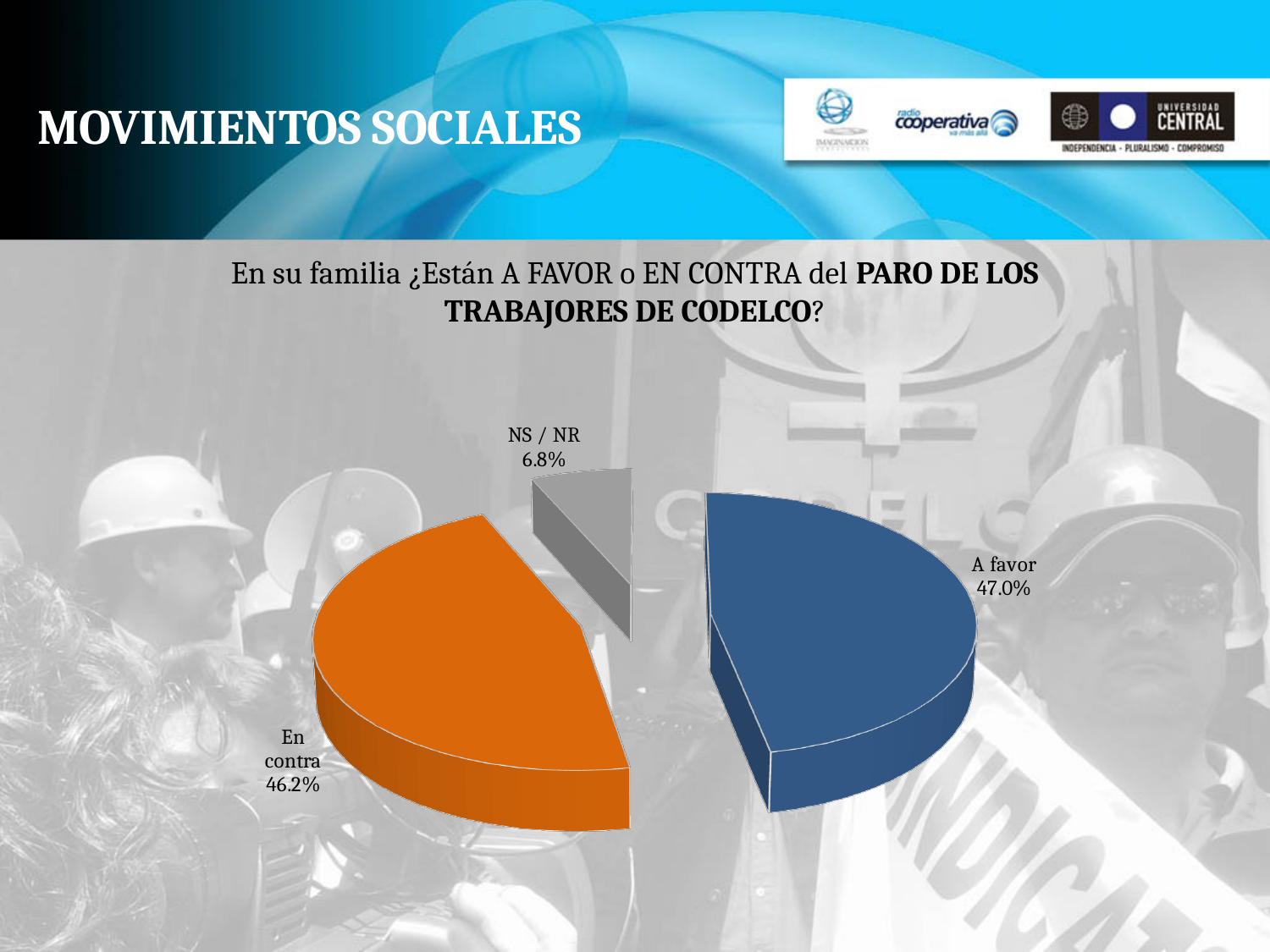
Which response has the smallest share of the pie? NS / NR Which is larger, the share for "En contra" or the share for "NS / NR"? En contra What percentage of respondents answered "NS / NR"? 6.8% What colour is the "En contra" slice of the pie? Orange Which response has the largest share of the pie? A favor What is the difference in percentage points between "En contra" and "NS / NR"? 39.4 percentage points What question does the chart title ask? En su familia ¿Están A FAVOR o EN CONTRA del PARO DE LOS TRABAJORES DE CODELCO? What kind of chart is shown on the slide? Pie chart How many slices does the pie chart have? 3 What is the difference in percentage points between "A favor" and "En contra"? 0.8 percentage points What percentage of respondents answered "A favor"? 47.0% What percentage of respondents answered "En contra"? 46.2%